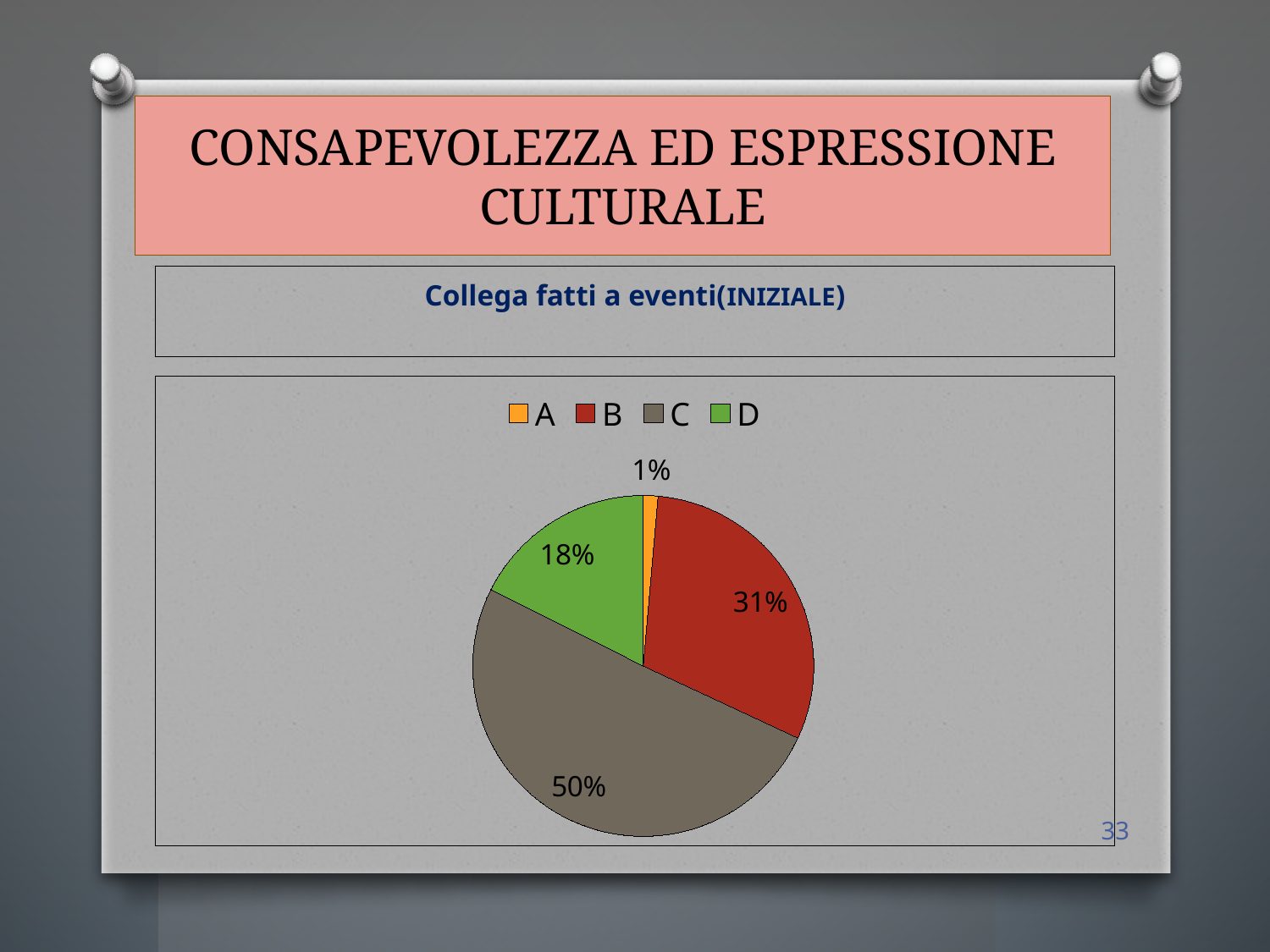
What colour is the slice for category D in the pie chart? green What percentage share does slice D have in the pie chart? 18% How many categories does the legend of the pie chart list? 4 Which category has the largest slice of the pie chart? C Which category has the smallest slice of the pie chart? A Which slice is larger, B or D? B What percentage share does slice C have in the pie chart? 50% What percentage share does slice A have in the pie chart? 1% What percentage share does slice B have in the pie chart? 31% What is the difference in percentage points between slice B and slice D? 13 What kind of chart is shown on the slide? pie chart What is the difference in percentage points between slice C and slice B? 19